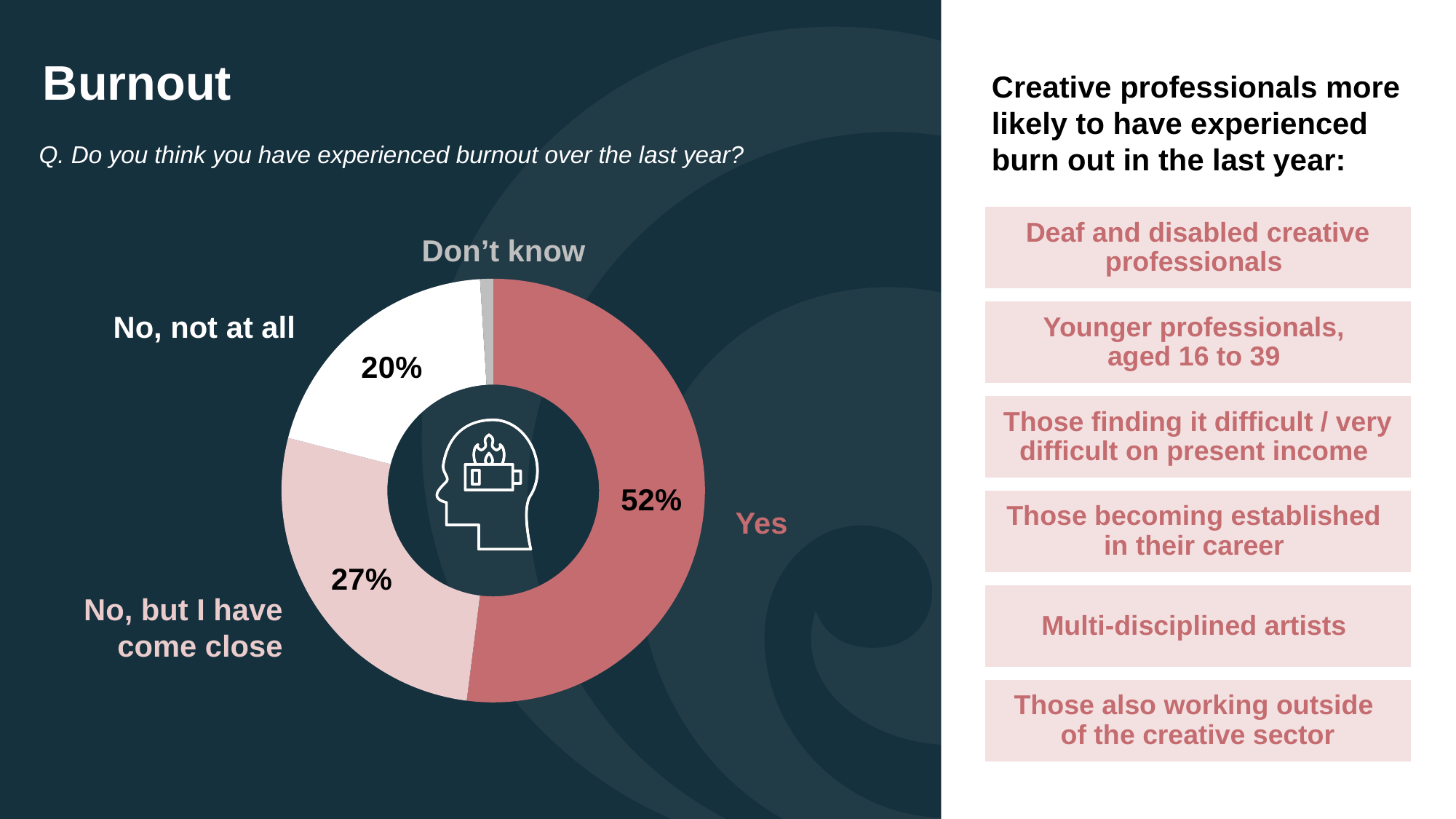
What is the difference in percentage points between "No, but I have come close" and "No, not at all"? 7 What percentage of respondents answered "No, not at all"? 20% What survey question is the chart based on? Do you think you have experienced burnout over the last year? Which is larger: the share for "No, not at all" or the share for "No, but I have come close"? No, but I have come close What is the difference in percentage points between "Yes" and "No, but I have come close"? 25 What percentage of respondents answered "No, but I have come close"? 27% Which response category has the smallest share of the donut chart? Don't know What percentage of respondents answered "Yes" to having experienced burnout over the last year? 52% Which response category has the largest share of the donut chart? Yes Is the share for "Yes" greater or less than 50%? greater How many response categories are shown in the donut chart? 4 What kind of chart is used to show the burnout survey responses? Donut (pie) chart